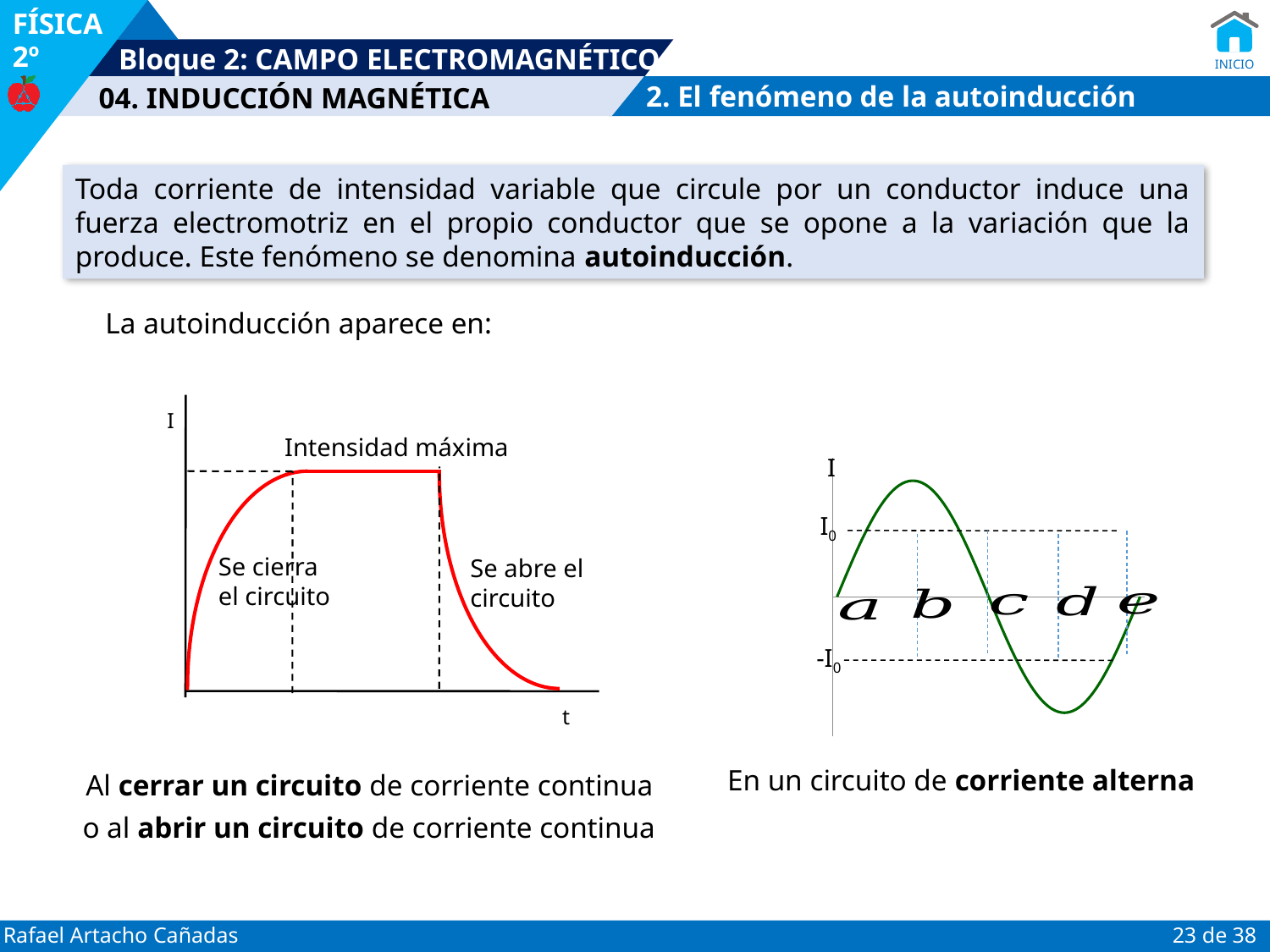
In the right chart, what label marks the lower dashed horizontal line on the I axis? -I0 In the right chart, is the current at point c greater or less than I0? less What kind of chart is the left graph showing current against time? line chart In the left chart, does the current rise or fall after the point marked 'Se abre el circuito'? fall What kind of chart is the right graph labelled 'En un circuito de corriente alterna'? line chart In the right chart, does the current rise or fall between points a and b? rise In the left chart, what is the label on the horizontal axis? t In the right chart, what label marks the upper dashed horizontal line on the I axis? I0 In the left chart, does the current rise or fall between the start of the curve and the point marked 'Se cierra el circuito'? rise In the left chart, what label is written next to the dashed horizontal line at the top of the curve? Intensidad máxima In the right chart, how many lettered points are marked along the horizontal axis? 5